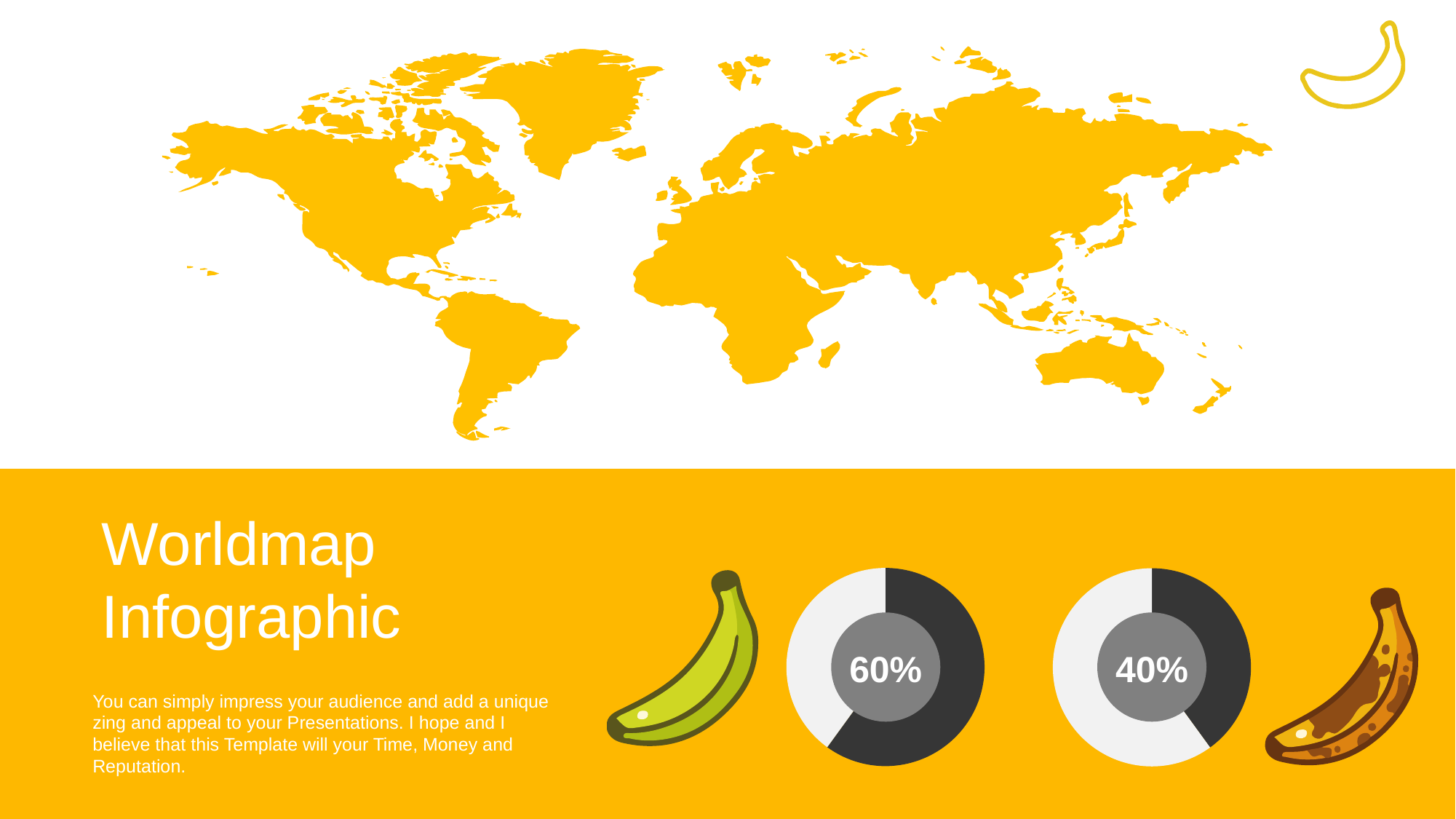
Is the value in the left donut chart greater or less than 50%? greater What is the difference between the percentage in the left donut chart and the percentage in the right donut chart? 20 percentage points What kind of chart is used to display the 60% and 40% values? Donut chart In the left donut chart, what share of the ring is filled with the dark colour? 60% Is the value in the right donut chart greater or less than 50%? less In the left donut chart, which colour fills the larger portion of the ring, dark grey or light grey? Dark grey What percentage is shown in the centre of the left donut chart? 60% In the right donut chart, what share of the ring is filled with the dark colour? 40% Which donut chart shows the larger percentage, the left one or the right one? The left one How many donut charts are on the slide? 2 Which donut chart has the smaller dark-coloured segment, the left one or the right one? The right one What percentage is shown in the centre of the right donut chart? 40%